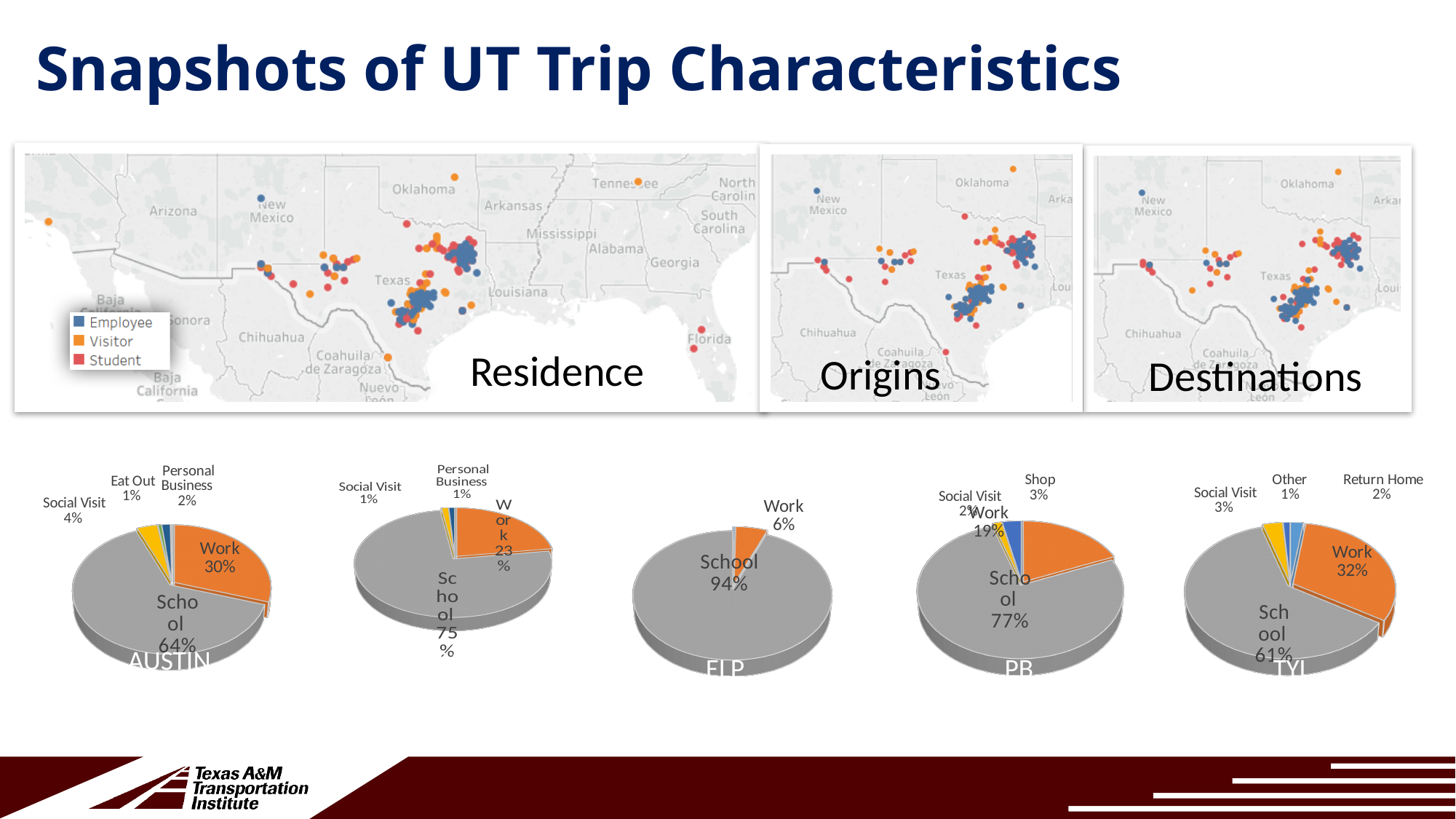
In the ELP pie chart, what share of trips is for School? 94% How many categories are labelled in the ELP pie chart? 2 How many categories are labelled in the TYL pie chart? 5 How many entries does the legend on the Residence map list? 3 In the AUSTIN pie chart, what is the difference between the School share and the Work share? 34% In the TYL pie chart, what share of trips is for Return Home? 2% In the AUSTIN pie chart, what share of trips is for School? 64% In the TYL pie chart, which category has the largest share? School In the AUSTIN pie chart, what share of trips is for Work? 30% Which is larger: the Work share in the TYL pie chart or the Work share in the PB pie chart? TYL In the PB pie chart, what share of trips is for Shop? 3% What kind of chart is used for the AUSTIN trip purposes? Pie chart